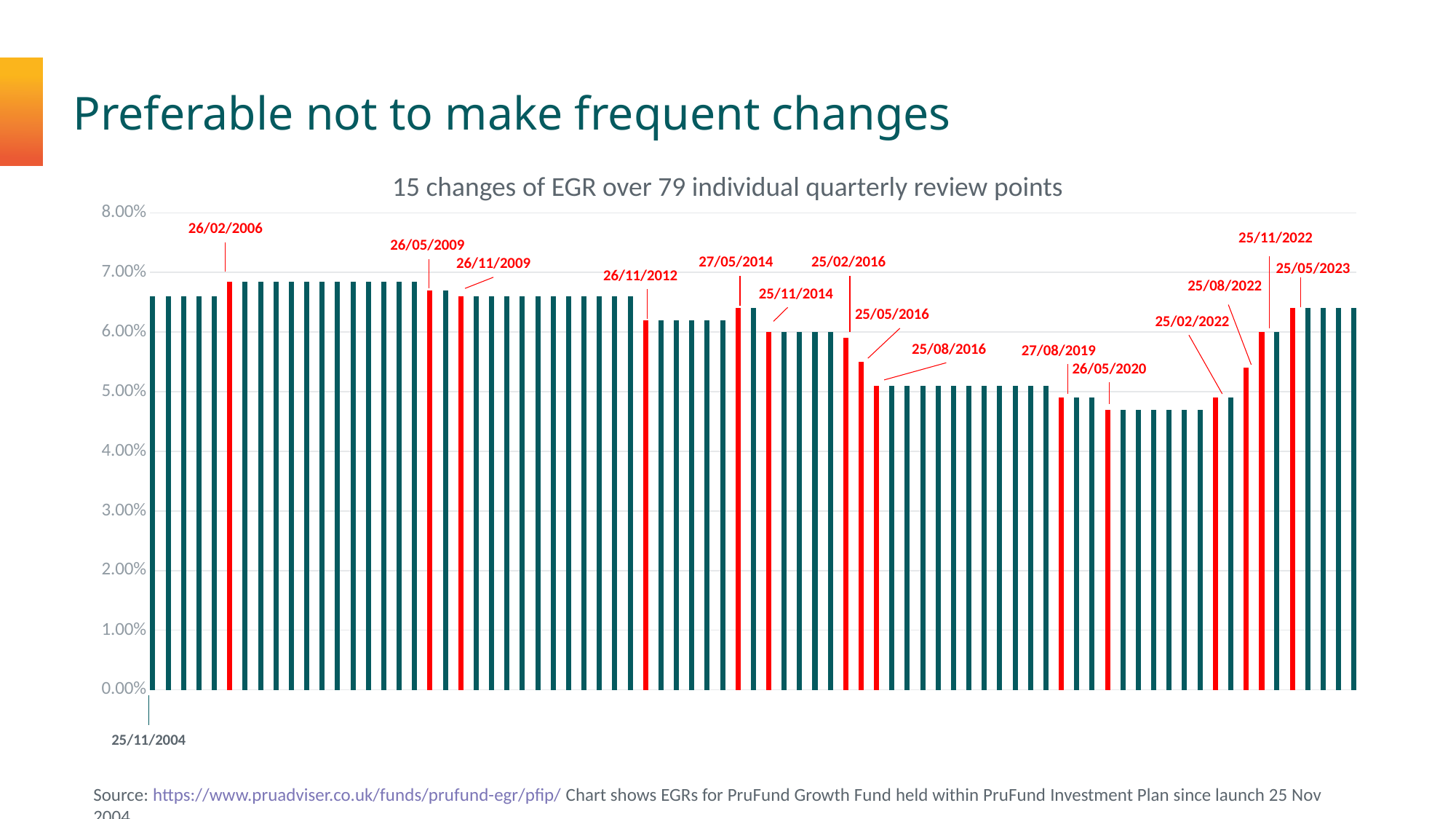
Is the value for the bar labelled 26/02/2006 greater or less than 6.00%? greater Is the value for the bar labelled 25/08/2022 greater or less than 5.00%? greater Do the values generally rise or fall between 26/02/2006 and 26/05/2020? fall What colour are the bars marking the review points where the EGR changed? Red What kind of chart is shown on the slide? Bar chart According to the chart title, how many individual quarterly review points are shown? 79 Which is larger, the value at 26/02/2006 or the value at 26/05/2020? 26/02/2006 Is the value for the bar labelled 25/08/2016 greater or less than 6.00%? less What is the title of the chart? 15 changes of EGR over 79 individual quarterly review points According to the chart title, how many changes of EGR are shown? 15